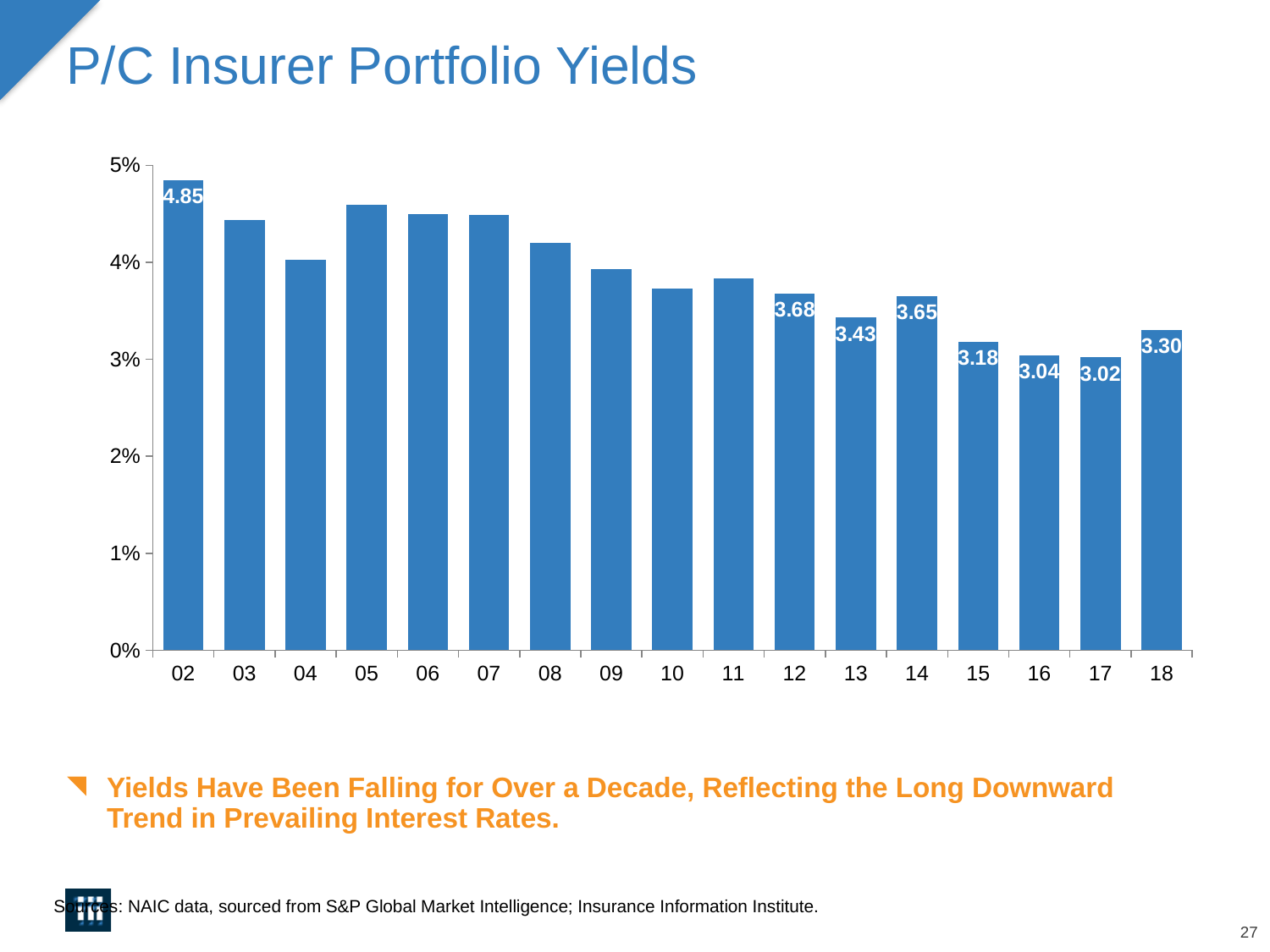
Which is larger, the yield in 2014 or the yield in 2015? 2014 How many years are shown on the x axis? 17 What is the portfolio yield shown for 2017? 3.02 What kind of chart is shown on the slide? bar chart What is the portfolio yield shown for 2014? 3.65 Which year has the lowest portfolio yield on the chart? 17 Is the value for 2010 greater or less than 4%? less Which year has the highest portfolio yield on the chart? 02 What is the difference between the yield in 2012 and the yield in 2013? 0.25 What is the portfolio yield shown for 2002? 4.85 What is the difference between the yield in 2002 and the yield in 2018? 1.55